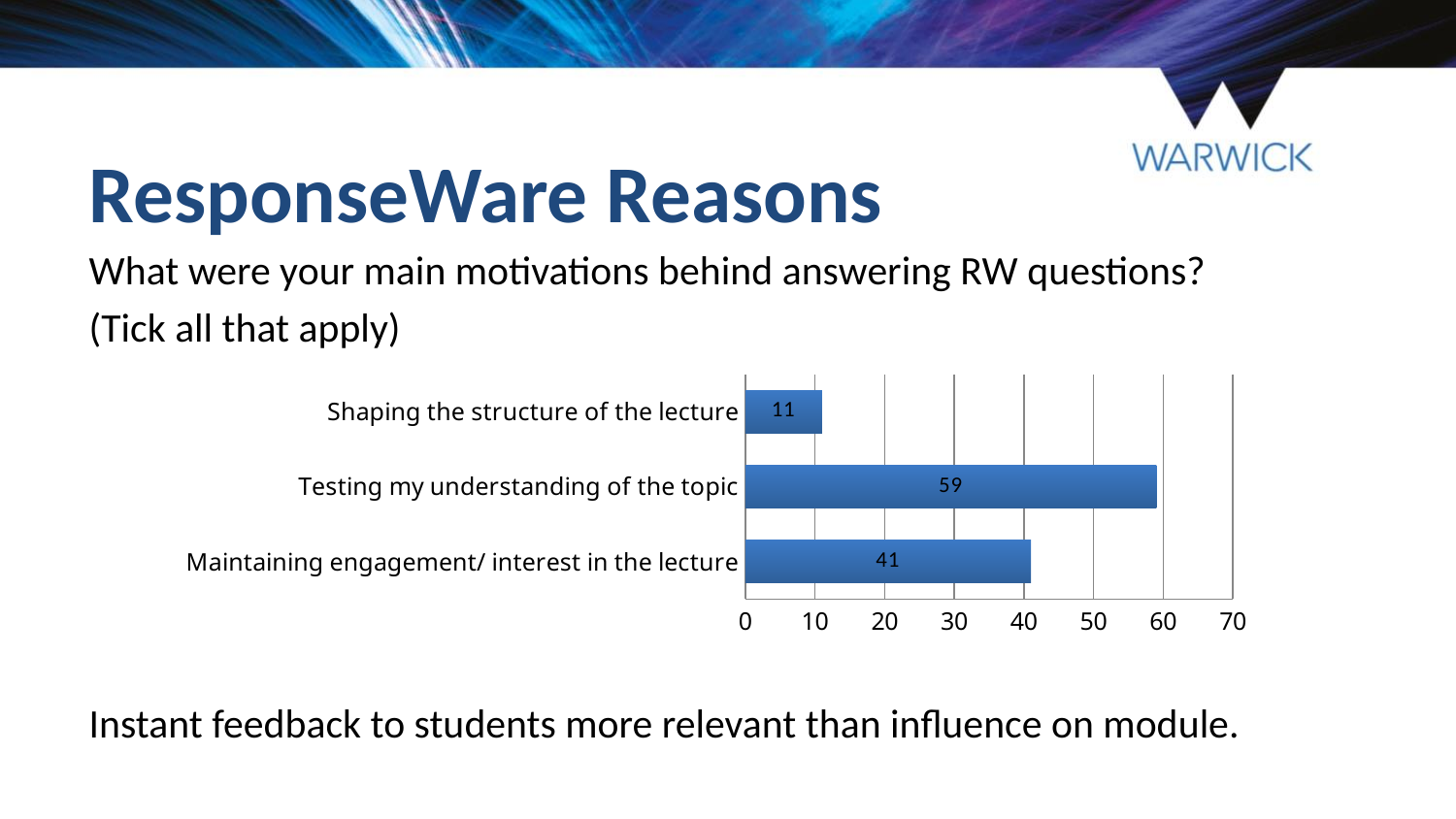
What is the value for 'Shaping the structure of the lecture'? 11 What is the difference between the values for 'Maintaining engagement/ interest in the lecture' and 'Shaping the structure of the lecture'? 30 What is the maximum value shown on the horizontal axis? 70 Is the value for 'Testing my understanding of the topic' greater or less than 50? greater Which is larger: the value for 'Maintaining engagement/ interest in the lecture' or 'Shaping the structure of the lecture'? Maintaining engagement/ interest in the lecture Which category has the lowest value? Shaping the structure of the lecture What is the difference between the values for 'Testing my understanding of the topic' and 'Maintaining engagement/ interest in the lecture'? 18 What kind of chart is shown on the slide? bar chart What is the value for 'Testing my understanding of the topic'? 59 Which category has the highest value? Testing my understanding of the topic What is the value for 'Maintaining engagement/ interest in the lecture'? 41 How many categories are shown in the chart? 3